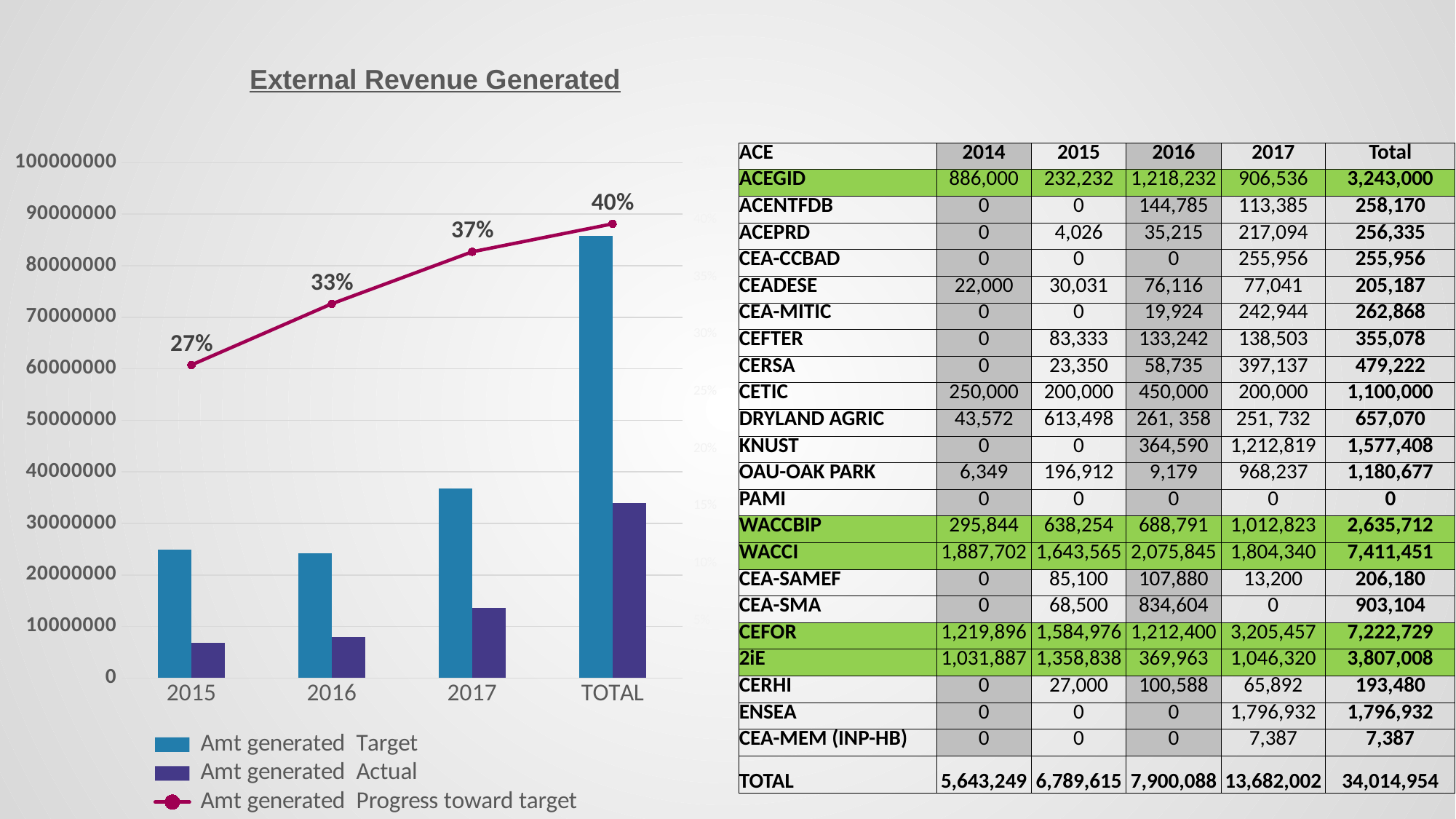
What is the title of the chart? External Revenue Generated What is the progress toward target value shown for 2017? 37% What is the progress toward target value shown for TOTAL? 40% What is the progress toward target value shown for 2015? 27% Does the progress toward target line rise or fall from 2015 to TOTAL? rise How many series does the chart legend list? 3 For 2017, which is larger: the Amt generated Target bar or the Amt generated Actual bar? Amt generated Target How many categories are shown on the x axis of the chart? 4 Is the Amt generated Target value for TOTAL greater or less than 80000000? greater Which category has the lowest progress toward target? 2015 Is the Amt generated Actual value for 2015 greater or less than 10000000? less What is the difference in progress toward target between TOTAL and 2015? 13 percentage points